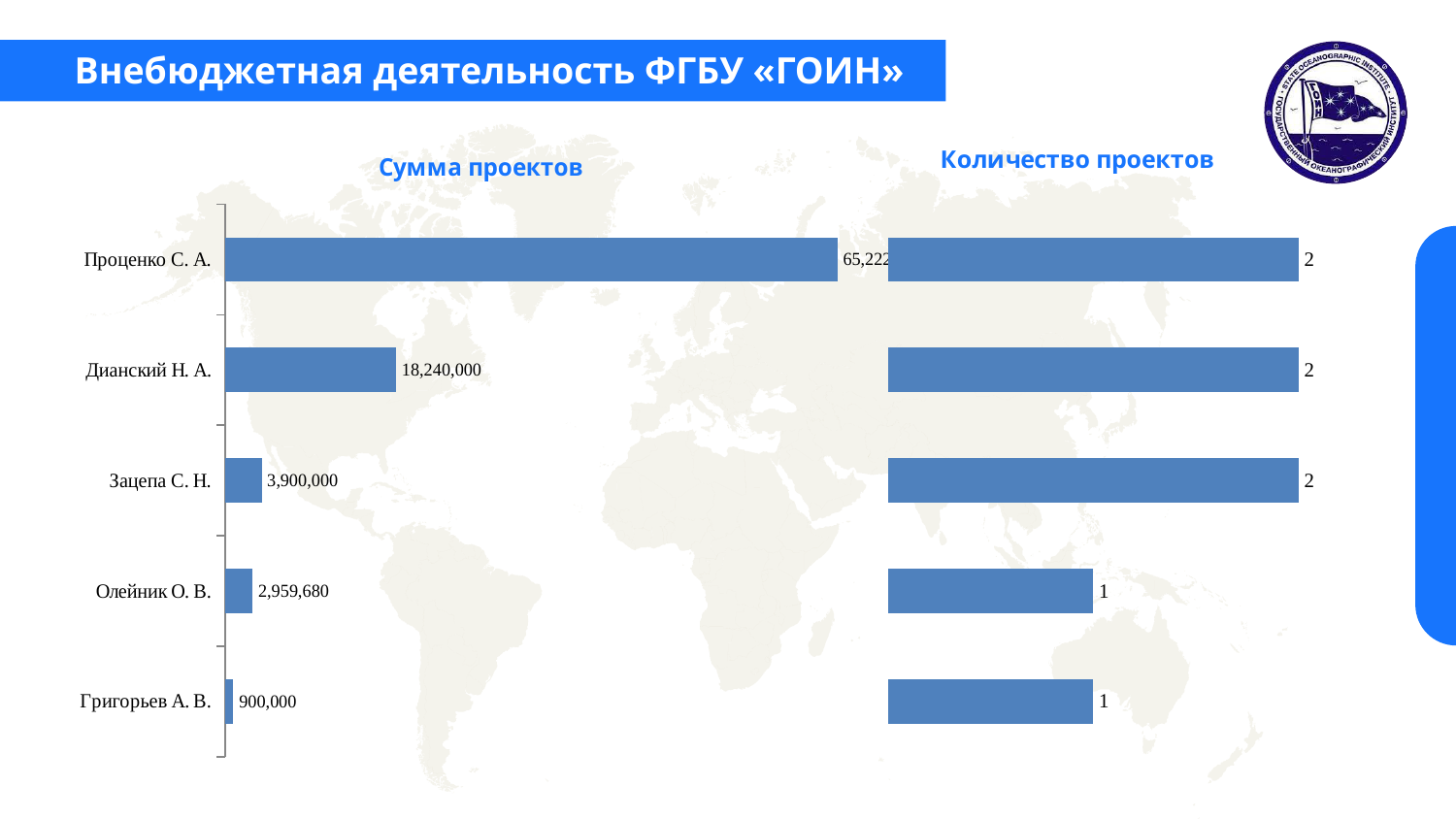
In the "Сумма проектов" chart, what is the value for Григорьев А. В.? 900,000 How many people are listed in the "Сумма проектов" chart? 5 In the "Сумма проектов" chart, which is larger: the value for Зацепа С. Н. or for Олейник О. В.? Зацепа С. Н. In the "Сумма проектов" chart, which person has the lowest value? Григорьев А. В. In the "Сумма проектов" chart, which person has the highest value? Проценко С. А. In the "Сумма проектов" chart, what is the value for Дианский Н. А.? 18,240,000 In the "Сумма проектов" chart, what is the difference between the values for Олейник О. В. and Григорьев А. В.? 2,059,680 In the "Сумма проектов" chart, what is the value for Зацепа С. Н.? 3,900,000 In the "Сумма проектов" chart, what is the value for Олейник О. В.? 2,959,680 In the "Сумма проектов" chart, what is the difference between the values for Дианский Н. А. and Зацепа С. Н.? 14,340,000 What type of chart is the "Количество проектов" chart? bar chart In the "Количество проектов" chart, what is the value for Олейник О. В.? 1